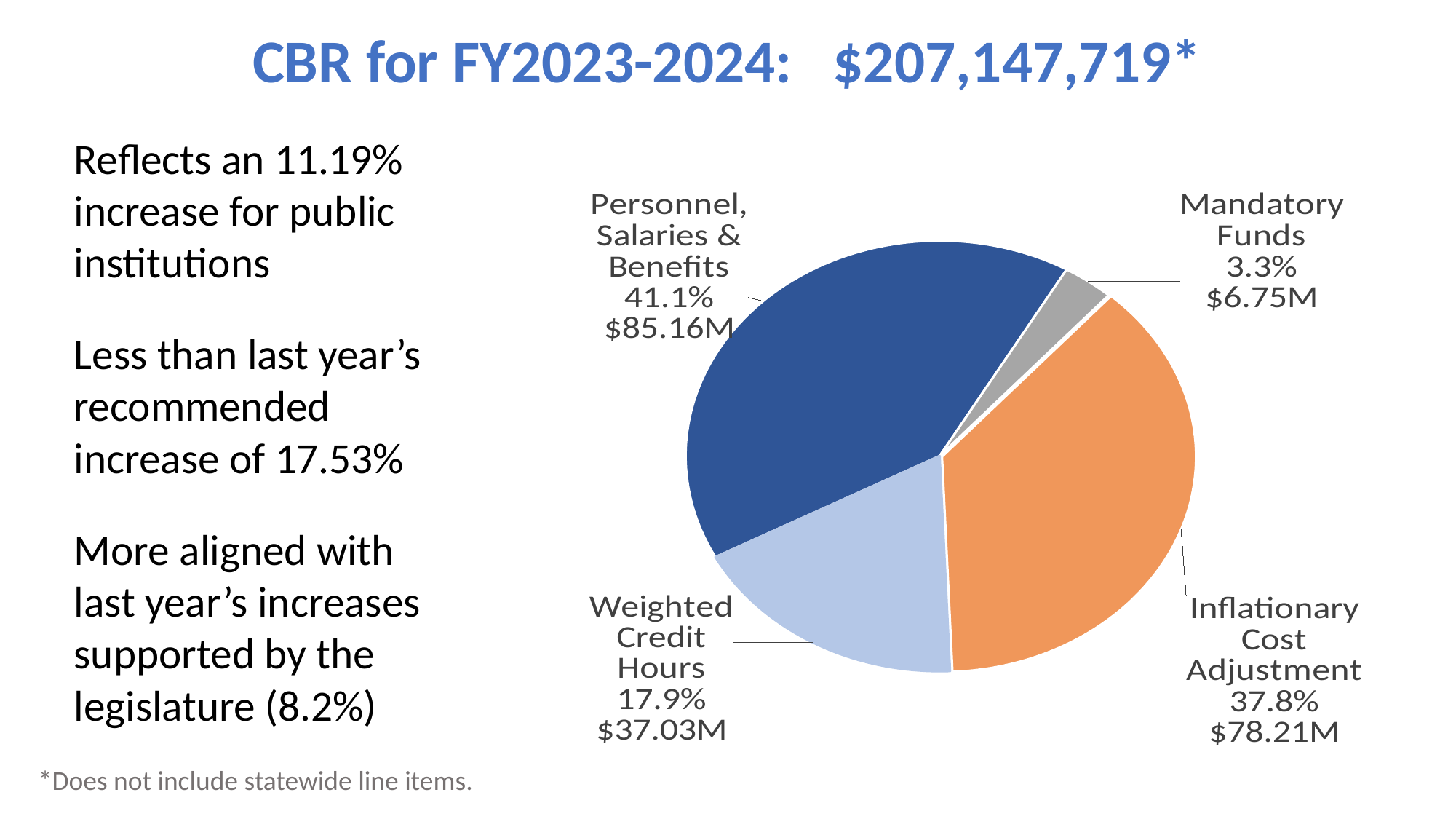
What is the dollar value shown for Weighted Credit Hours? $37.03M What share of the pie does Mandatory Funds represent? 3.3% What kind of chart is shown on the slide? pie chart Which category has the largest slice of the pie? Personnel, Salaries & Benefits Which category has the smallest slice of the pie? Mandatory Funds What is the dollar value shown for Mandatory Funds? $6.75M What share of the pie does Personnel, Salaries & Benefits represent? 41.1% What is the dollar value shown for Inflationary Cost Adjustment? $78.21M What is the difference in percentage points between Personnel, Salaries & Benefits and Inflationary Cost Adjustment? 3.3 Which is larger, Inflationary Cost Adjustment or Weighted Credit Hours? Inflationary Cost Adjustment What colour is the Inflationary Cost Adjustment slice? orange How many slices does the pie chart have? 4